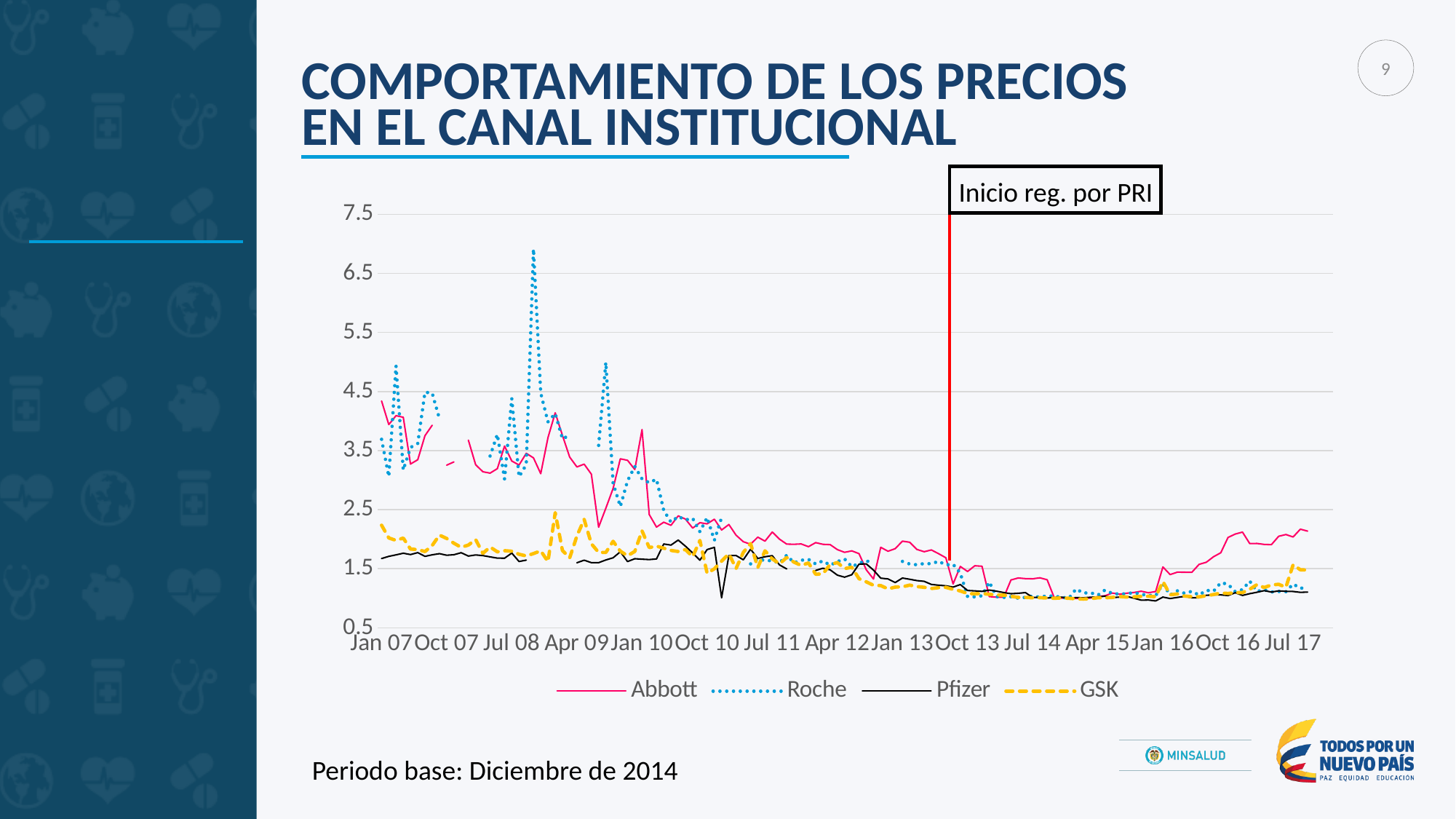
Is the value for Pfizer at Jan 07 greater or less than 2.5? less At Jan 07, which series has the larger value, Abbott or Pfizer? Abbott What does the annotation next to the red vertical line say? Inicio reg. por PRI Is the value for Abbott at Jan 07 greater or less than 3.5? greater Does the Abbott series overall rise or fall from Jan 07 to Jul 17? fall Which series reaches the highest peak value on the chart? Roche How many series does the legend list? 4 Is the value for Abbott at Jul 17 greater or less than 1.5? greater Which series are listed in the chart legend? Abbott, Roche, Pfizer, GSK What kind of chart is shown on the slide? line chart